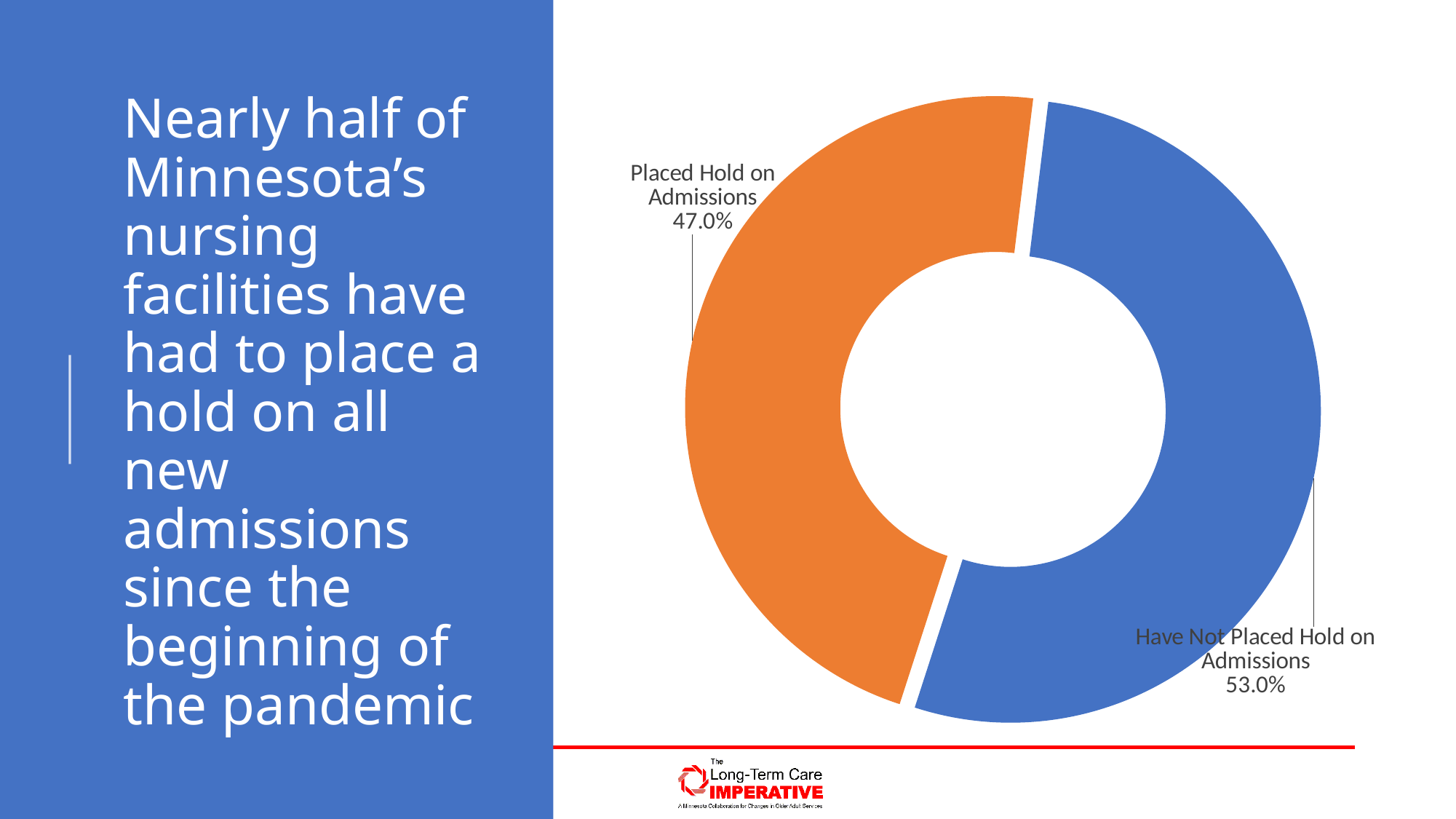
What colour is the Placed Hold on Admissions segment? Orange Which category has the larger share of the chart? Have Not Placed Hold on Admissions How many categories are shown in the chart? 2 What colour is the Have Not Placed Hold on Admissions segment? Blue Is the share for Placed Hold on Admissions larger or smaller than the share for Have Not Placed Hold on Admissions? smaller What percentage of facilities placed a hold on admissions? 47.0% What percentage of facilities have not placed a hold on admissions? 53.0% Which category has the smaller share of the chart? Placed Hold on Admissions What is the difference in percentage points between the two categories? 6.0% What is the total of the two percentages shown in the chart? 100.0% What kind of chart is shown on the slide? Doughnut (pie) chart